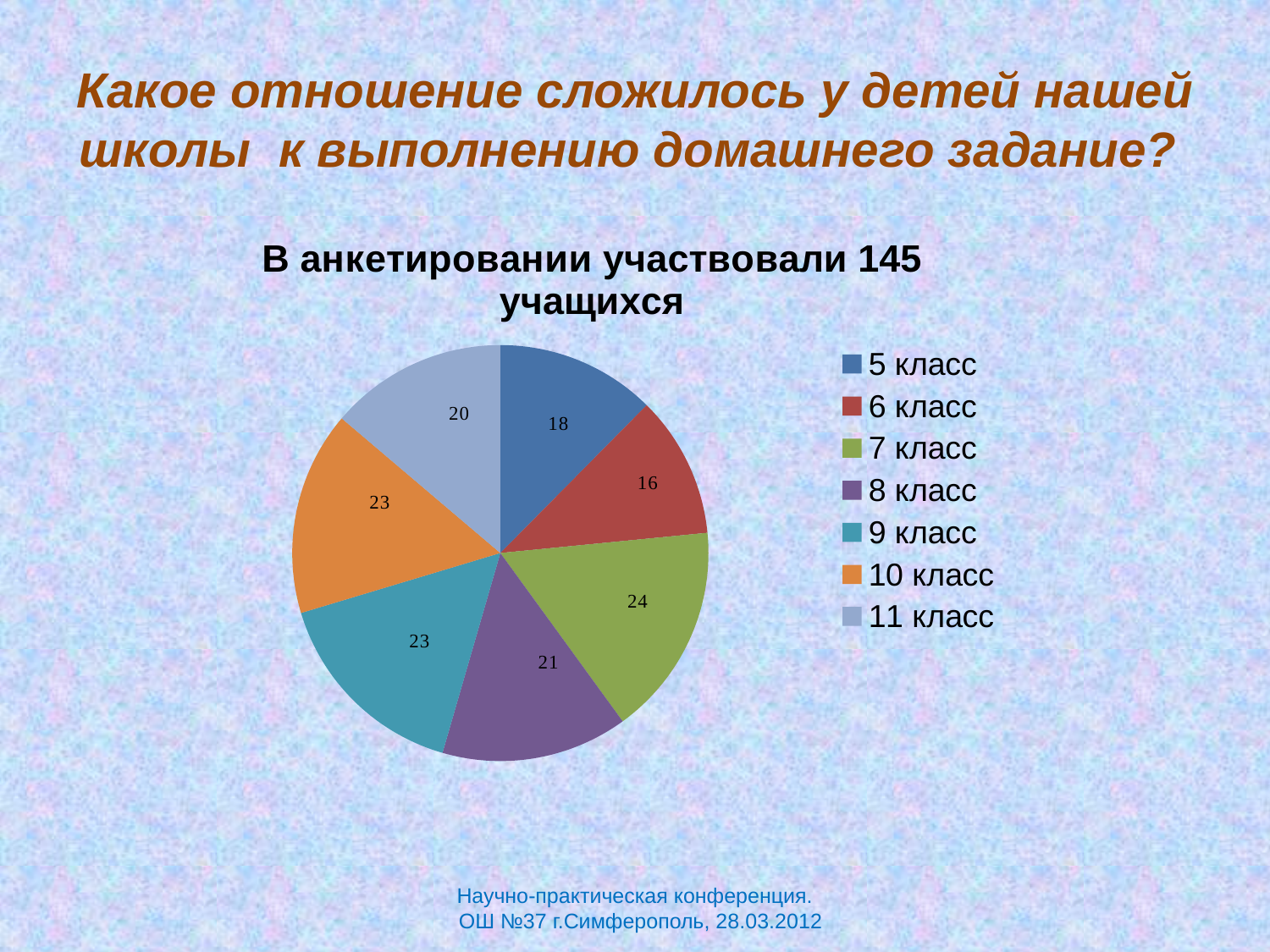
Which is larger, the value for 5 класс or the value for 11 класс? 11 класс Which class has the largest slice in the pie chart? 7 класс What is the title of the pie chart? В анкетировании участвовали 145 учащихся What type of chart is shown on the slide? pie chart What is the value for 8 класс in the pie chart? 21 What is the value for 11 класс in the pie chart? 20 What is the difference between the values for 7 класс and 6 класс? 8 What is the value for 7 класс in the pie chart? 24 What is the value for 6 класс in the pie chart? 16 Which class has the smallest slice in the pie chart? 6 класс How many entries does the legend list? 7 How many slices does the pie chart have? 7